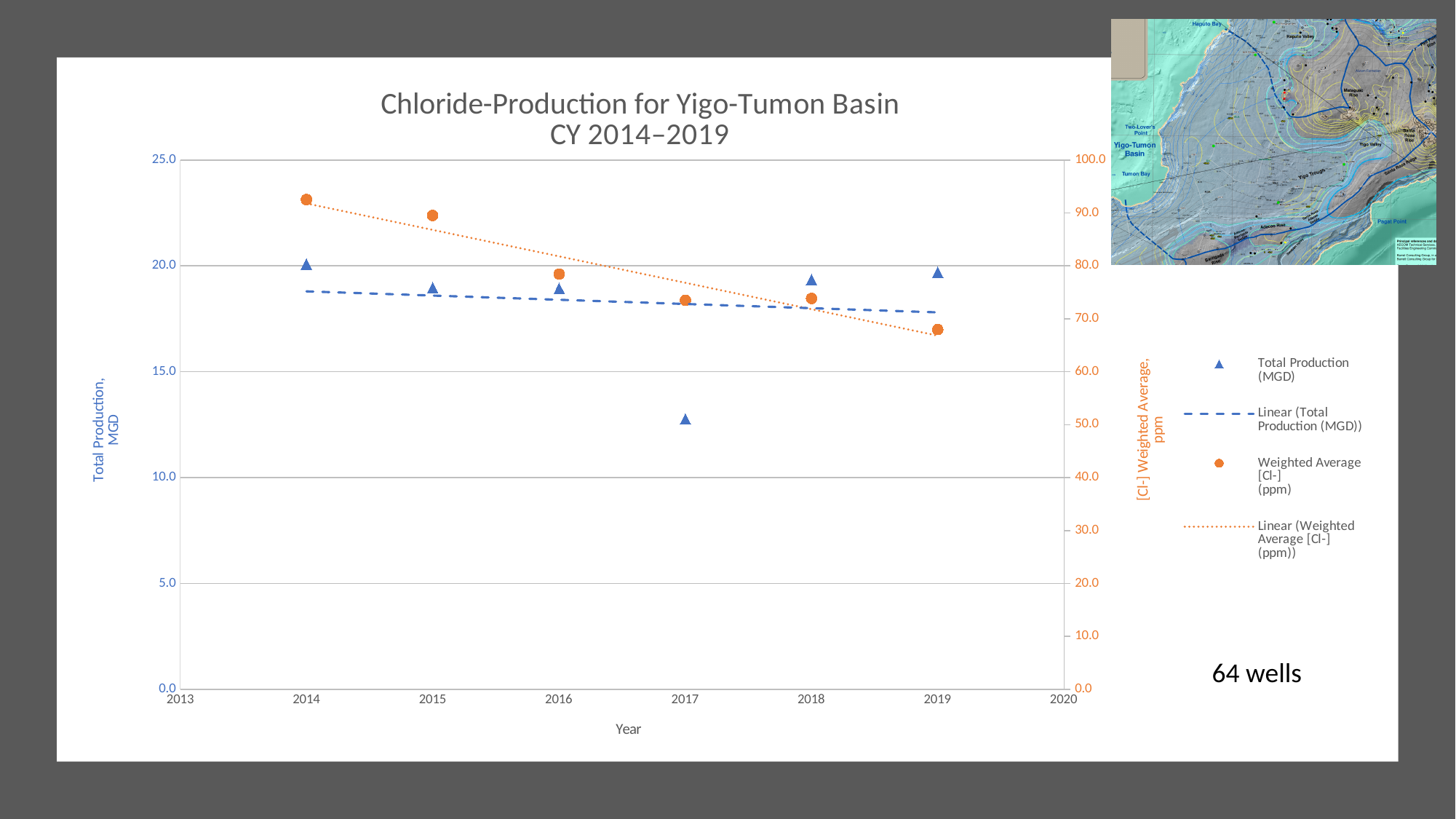
How many entries does the chart legend list? 4 Is the Total Production (MGD) value for 2017 greater or less than 15.0? less In which year is the Weighted Average [Cl-] (ppm) lowest? 2019 Which year has the larger Total Production (MGD), 2017 or 2018? 2018 How many years have Total Production (MGD) data points plotted? 6 In which year is the Weighted Average [Cl-] (ppm) highest? 2014 Does the Weighted Average [Cl-] (ppm) generally rise or fall from 2014 to 2019? fall In which year is Total Production (MGD) lowest? 2017 What is the title of the chart? Chloride-Production for Yigo-Tumon Basin CY 2014–2019 Is the Weighted Average [Cl-] (ppm) value for 2014 greater or less than 90.0? greater Is the Weighted Average [Cl-] (ppm) value for 2019 greater or less than 70.0? less What kind of chart is shown on the slide? scatter chart